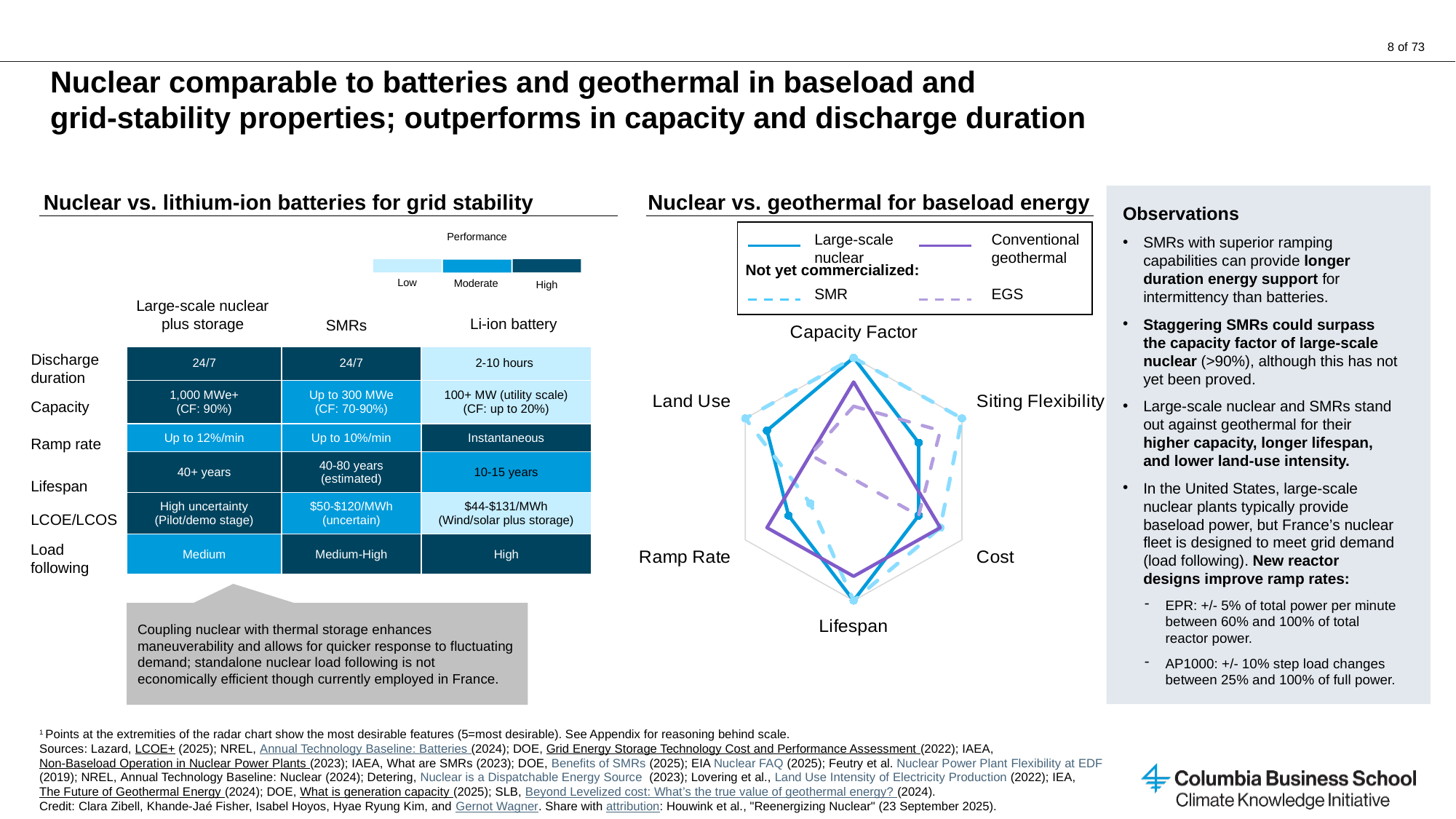
How many axes (categories) does the radar chart 'Nuclear vs. geothermal for baseload energy' have? 6 In the radar chart 'Nuclear vs. geothermal for baseload energy', which axis is at the top of the chart? Capacity Factor How many series does the legend of the radar chart 'Nuclear vs. geothermal for baseload energy' list? 4 In the radar chart 'Nuclear vs. geothermal for baseload energy', which scores higher on Cost: Conventional geothermal or Large-scale nuclear? Conventional geothermal In the radar chart 'Nuclear vs. geothermal for baseload energy', which series are labelled as not yet commercialized? SMR and EGS In the radar chart 'Nuclear vs. geothermal for baseload energy', which scores higher on Land Use: Large-scale nuclear or Conventional geothermal? Large-scale nuclear What kind of chart is 'Nuclear vs. geothermal for baseload energy'? Radar chart In the radar chart 'Nuclear vs. geothermal for baseload energy', which series is drawn with a solid purple line? Conventional geothermal In the radar chart 'Nuclear vs. geothermal for baseload energy', which scores higher on Capacity Factor: Large-scale nuclear or Conventional geothermal? Large-scale nuclear